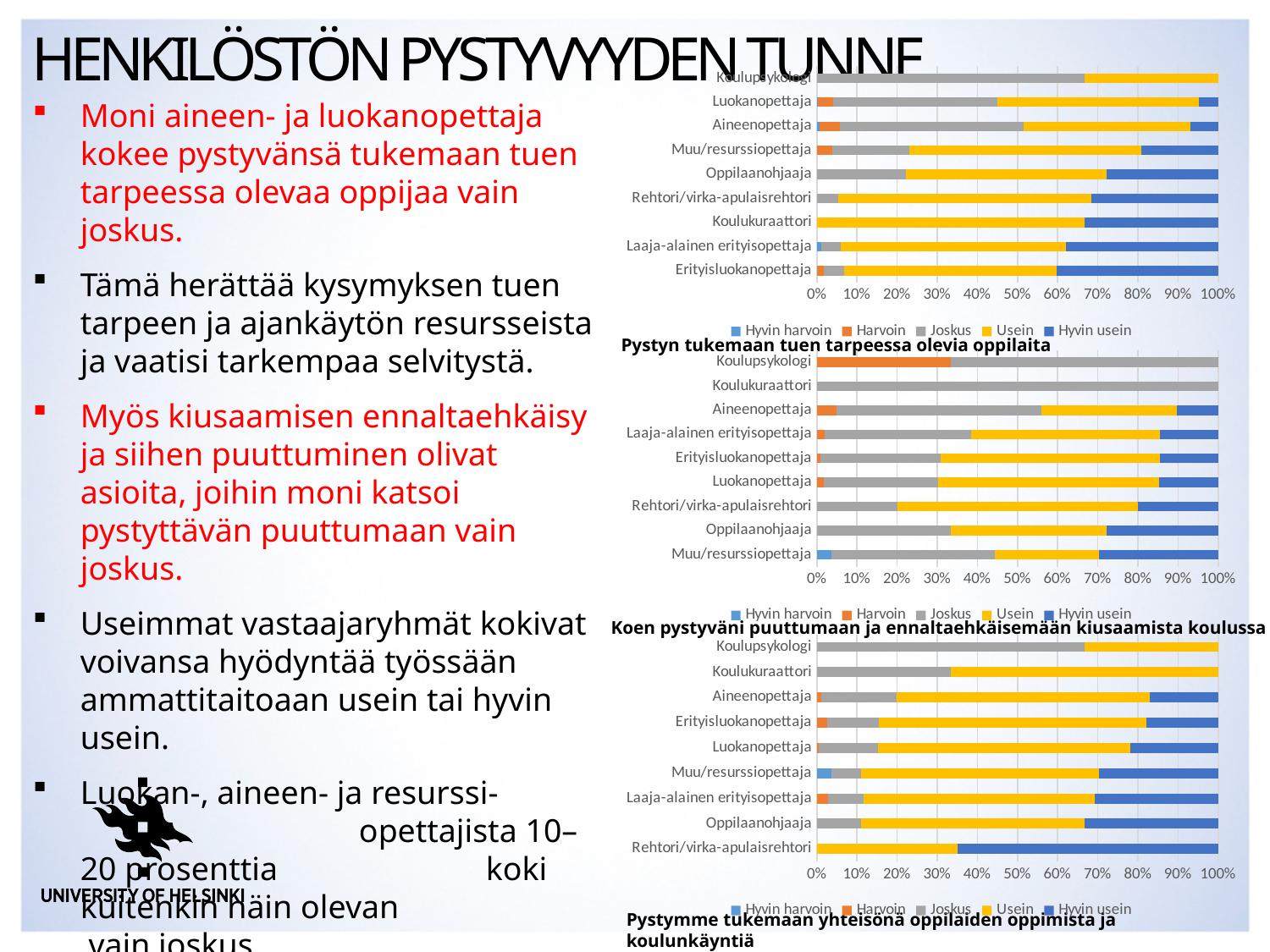
Which legend entry is shown in yellow in the charts? Usein How many respondent groups (categories) are shown in the top chart? 9 How many series does the legend of the top chart list? 5 In the top chart, is the Joskus value for Koulupsykologi greater or less than 50%? greater What kind of chart is the top chart on the slide? stacked bar chart In the middle chart, is the Joskus value for Rehtori/virka-apulaisrehtori greater or less than 30%? less Which category is listed first (at the top) in the middle chart? Koulupsykologi In the bottom chart, is the Hyvin usein value for Rehtori/virka-apulaisrehtori greater or less than 50%? greater How many respondent groups (categories) are shown in the middle chart? 9 How many respondent groups (categories) are shown in the bottom chart? 9